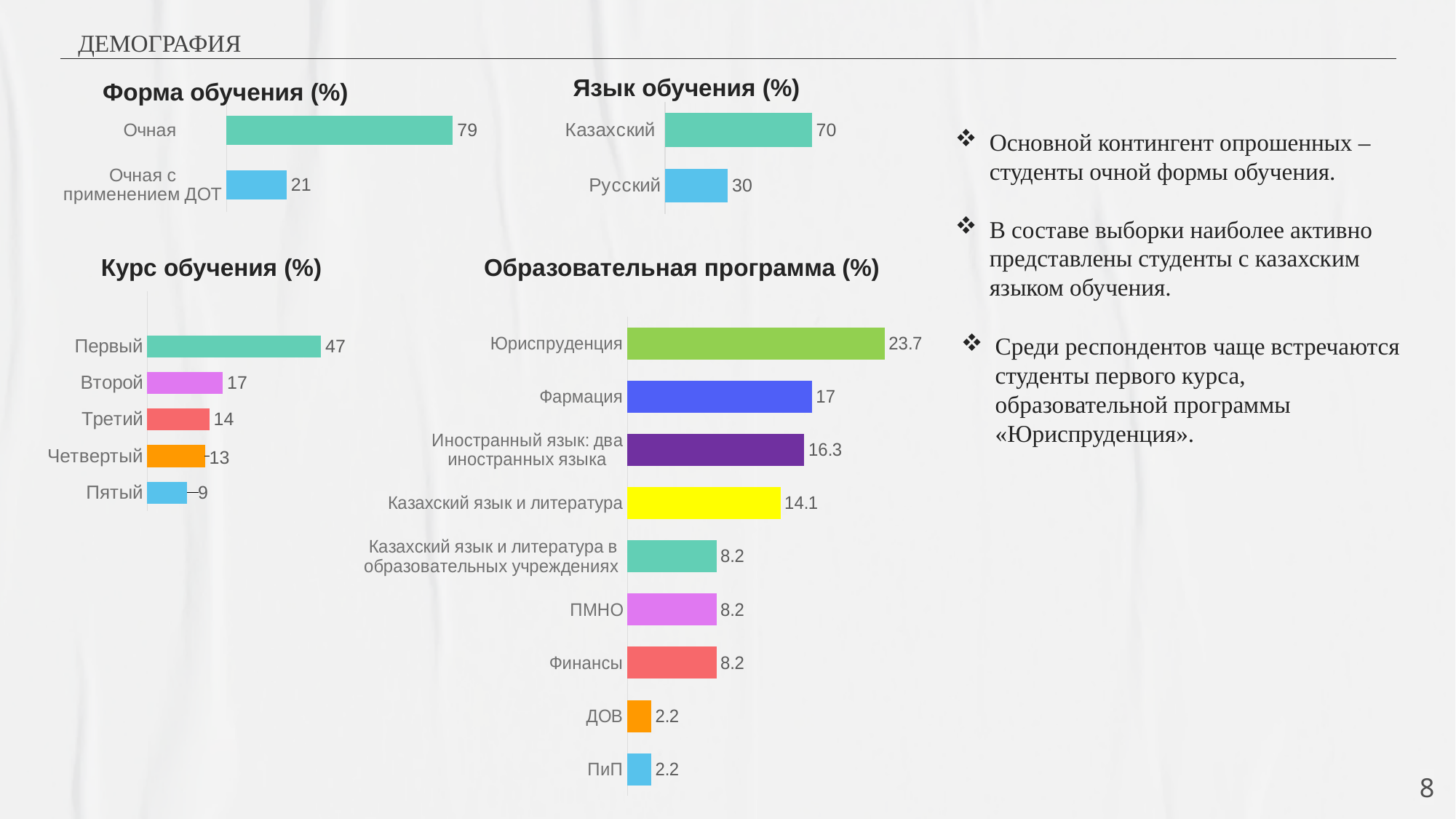
In the chart titled "Курс обучения (%)", how many categories are shown? 5 In the chart titled "Курс обучения (%)", which category has the lowest value? Пятый In the chart titled "Курс обучения (%)", which category has the highest value? Первый In the chart titled "Образовательная программа (%)", which category has the highest value? Юриспруденция In the chart titled "Образовательная программа (%)", which is larger: the value for "Иностранный язык: два иностранных языка" or the value for "Казахский язык и литература"? Иностранный язык: два иностранных языка In the chart titled "Образовательная программа (%)", what is the value for "Фармация"? 17 In the chart titled "Образовательная программа (%)", how many categories are shown? 9 In the chart titled "Курс обучения (%)", what is the value for "Третий"? 14 What kind of chart is the chart titled "Образовательная программа (%)"? Bar chart In the chart titled "Форма обучения (%)", what is the value for "Очная"? 79 In the chart titled "Язык обучения (%)", what is the value for "Русский"? 30 In the chart titled "Язык обучения (%)", what is the difference between the values for "Казахский" and "Русский"? 40